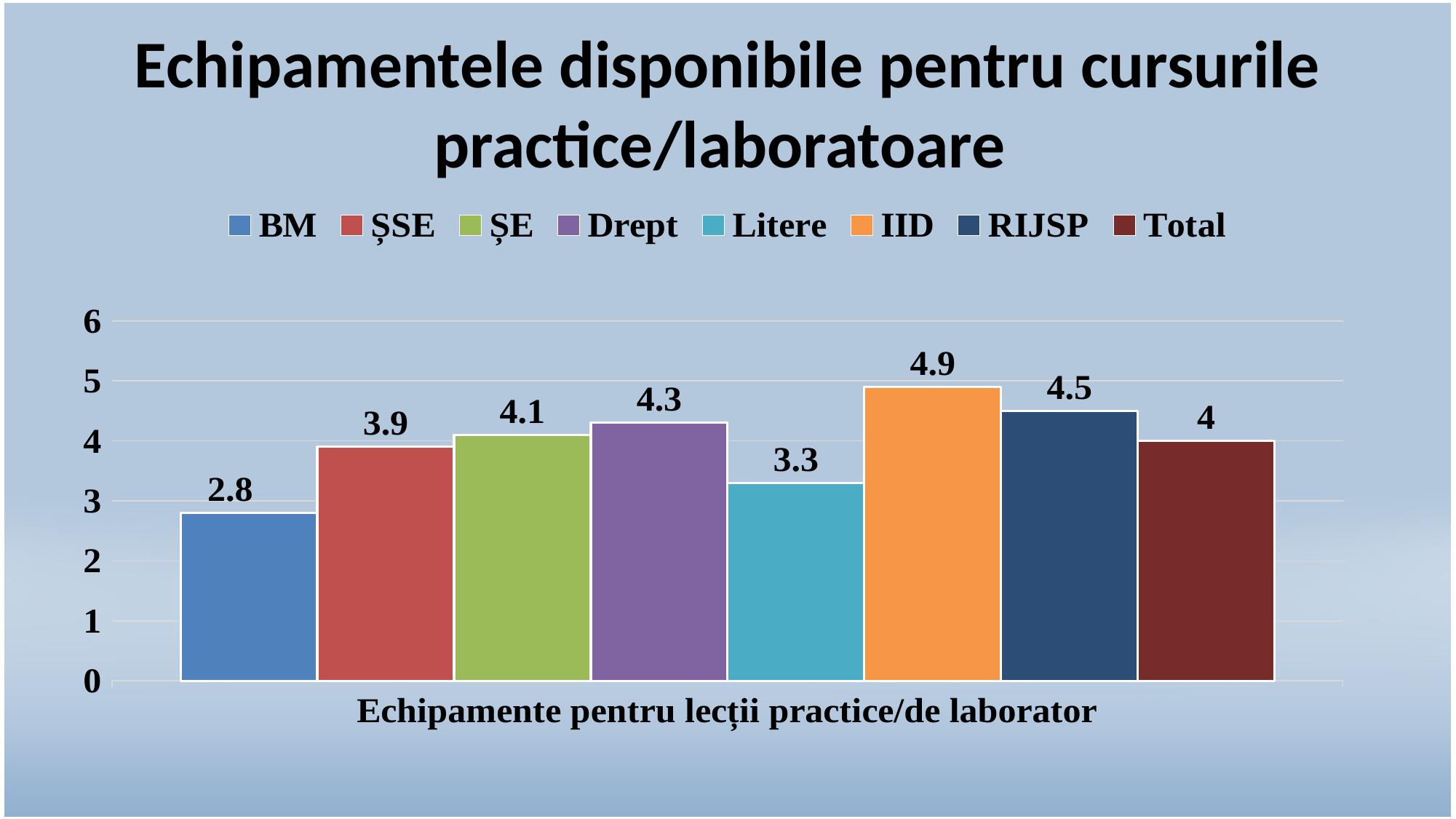
What is the x-axis label of the chart? Echipamente pentru lecții practice/de laborator Which series has the highest value? IID What is the value for Total? 4 What is the value for IID? 4.9 How many series does the legend list? 8 Which is larger, the value for ȘSE or the value for Litere? ȘSE What is the value for Litere? 3.3 Which series has the lowest value? BM What is the difference between the values for IID and BM? 2.1 What is the difference between the values for RIJSP and Drept? 0.2 What is the value for BM? 2.8 What kind of chart is shown on the slide? bar chart